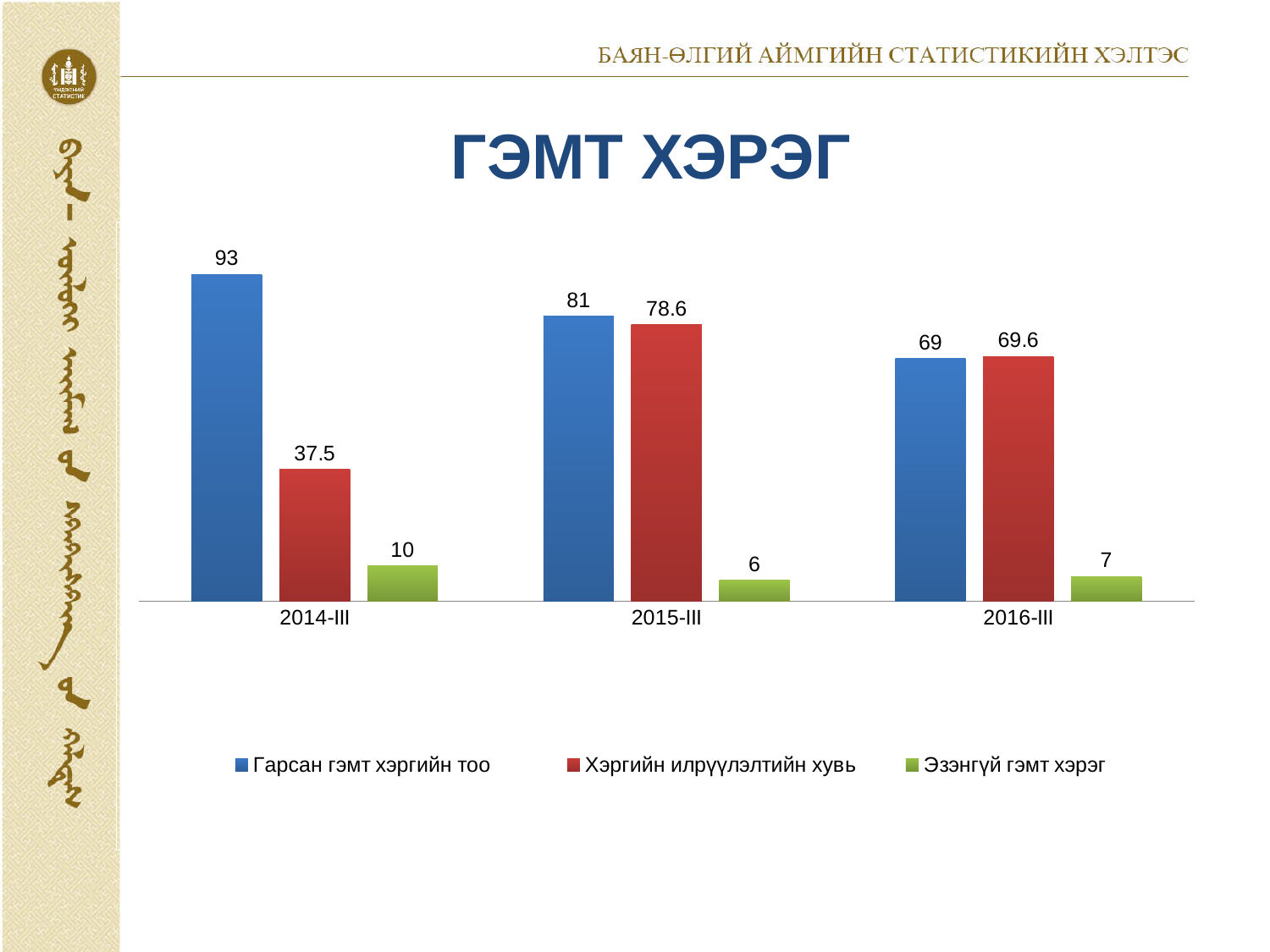
In which period is Гарсан гэмт хэргийн тоо highest? 2014-III What is the title of the chart? ГЭМТ ХЭРЭГ How many periods are shown on the x axis? 3 How many series does the legend list? 3 What is the value of Эзэнгүй гэмт хэрэг for 2016-III? 7 What is the difference between Гарсан гэмт хэргийн тоо in 2014-III and 2016-III? 24 What kind of chart is shown on the slide? Bar chart In which period is Хэргийн илрүүлэлтийн хувь lowest? 2014-III Which is larger in 2015-III: Гарсан гэмт хэргийн тоо or Хэргийн илрүүлэлтийн хувь? Гарсан гэмт хэргийн тоо Does Гарсан гэмт хэргийн тоо rise or fall from 2014-III to 2016-III? Fall What is the value of Гарсан гэмт хэргийн тоо for 2014-III? 93 What is the value of Хэргийн илрүүлэлтийн хувь for 2015-III? 78.6